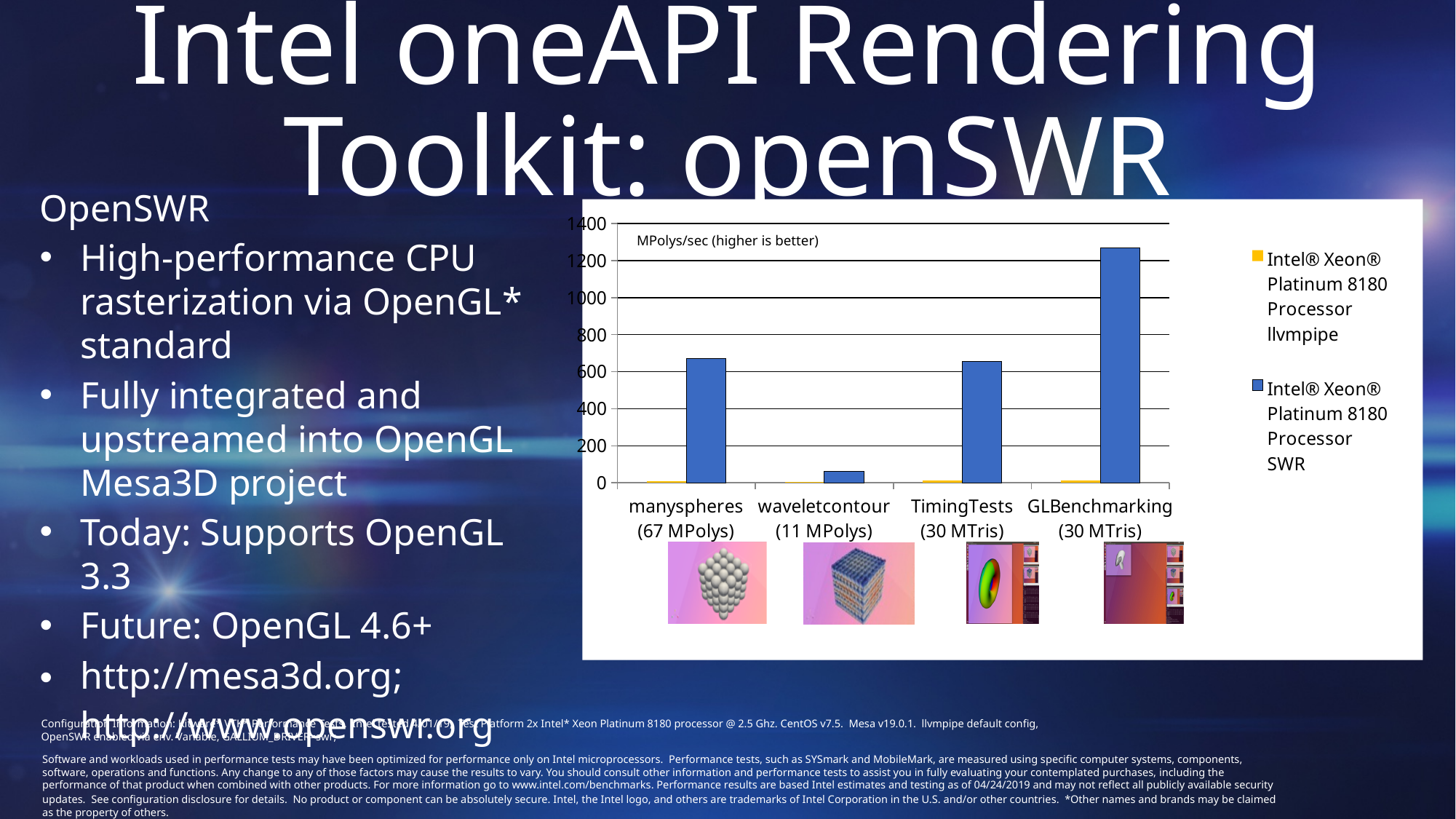
What unit label is printed inside the chart's plot area? MPolys/sec (higher is better) Is the SWR value for waveletcontour greater or less than 200? less What kind of chart is shown on the slide? bar chart Which benchmark has the lowest SWR value in the chart? waveletcontour (11 MPolys) How many benchmark categories are shown on the x axis of the chart? 4 Is the SWR value for TimingTests greater or less than 800? less Is the SWR value for manyspheres greater or less than 600? greater For manyspheres, which series has the larger value: llvmpipe or SWR? SWR Which benchmark has the highest SWR value in the chart? GLBenchmarking (30 MTris) Which is larger: the SWR value for GLBenchmarking or the SWR value for TimingTests? GLBenchmarking How many series does the chart's legend list? 2